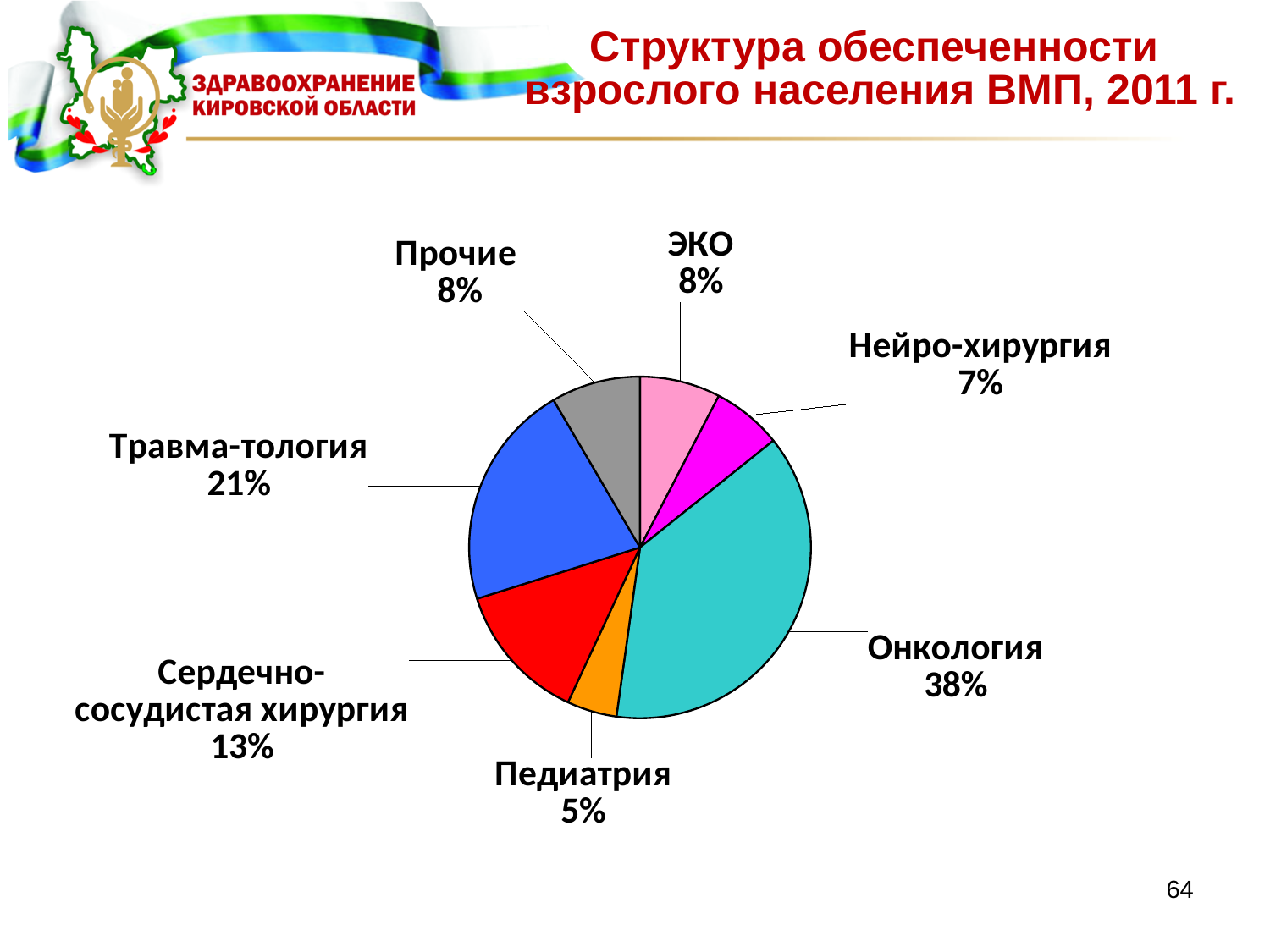
Which is larger, the share for Сердечно-сосудистая хирургия or the share for ЭКО? Сердечно-сосудистая хирургия Which category has the largest share of the pie? Онкология What is the difference between the shares of Онкология and Травма-тология? 17% What is the value for Педиатрия? 5% How many categories are shown in the pie chart? 7 Which category has the smallest share of the pie? Педиатрия What is the value for Нейро-хирургия? 7% What colour is the Онкология slice? Turquoise What type of chart is shown on the slide? Pie chart What is the value for Сердечно-сосудистая хирургия? 13% What share of the pie does Онкология have? 38% What is the value for Травма-тология? 21%